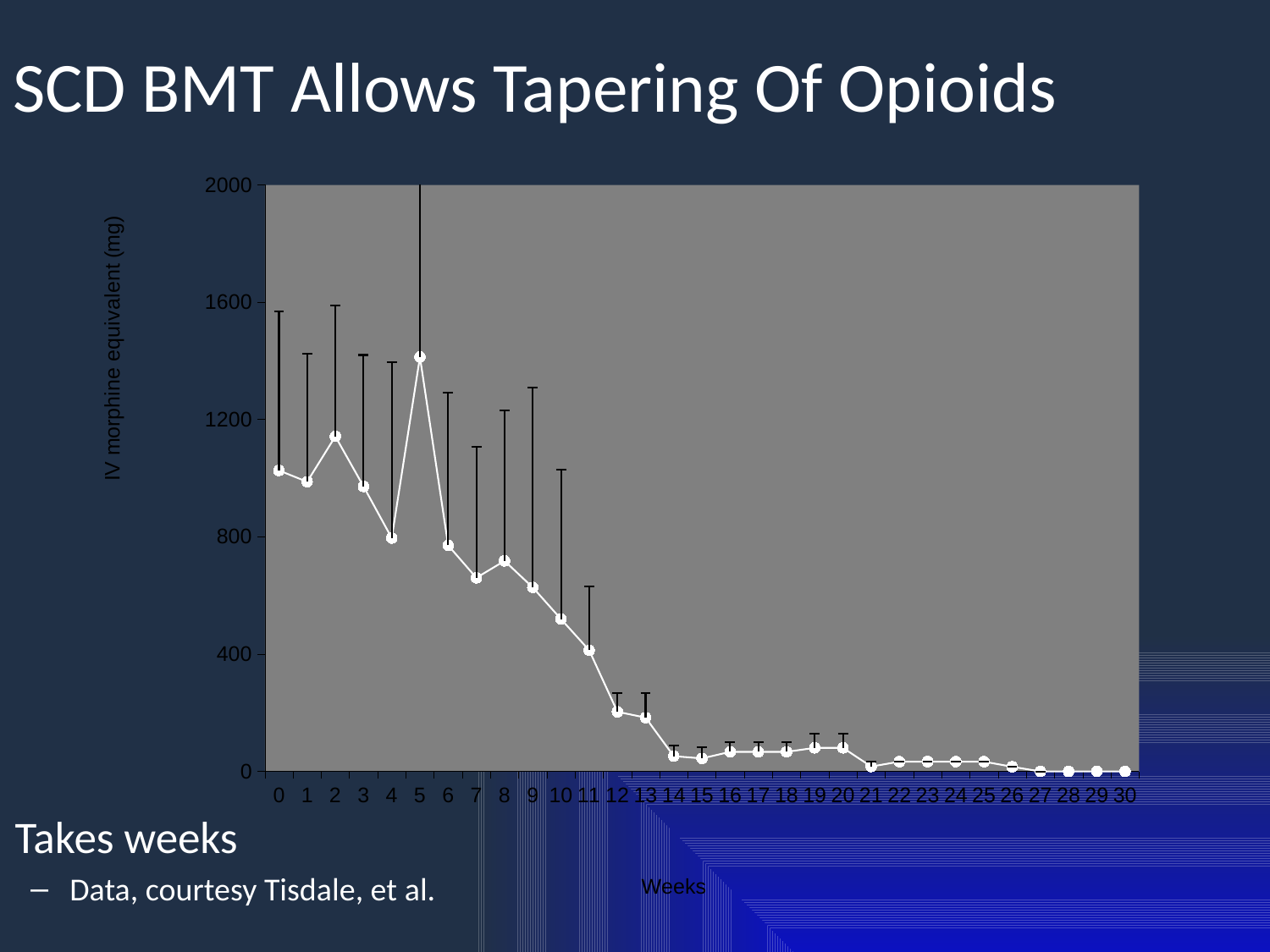
Is the value at week 0 greater or less than 800? greater Which is larger, the value at week 0 or the value at week 12? week 0 What kind of chart is shown on the slide? line chart Overall, do the values rise or fall as the weeks increase? fall At which week is the IV morphine equivalent highest? 5 How many weekly data points are plotted on the chart? 31 Which is larger, the value at week 2 or the value at week 4? week 2 Is the value at week 5 greater or less than 1200? greater Is the value at week 9 greater or less than 800? less What is the label of the vertical axis? IV morphine equivalent (mg)